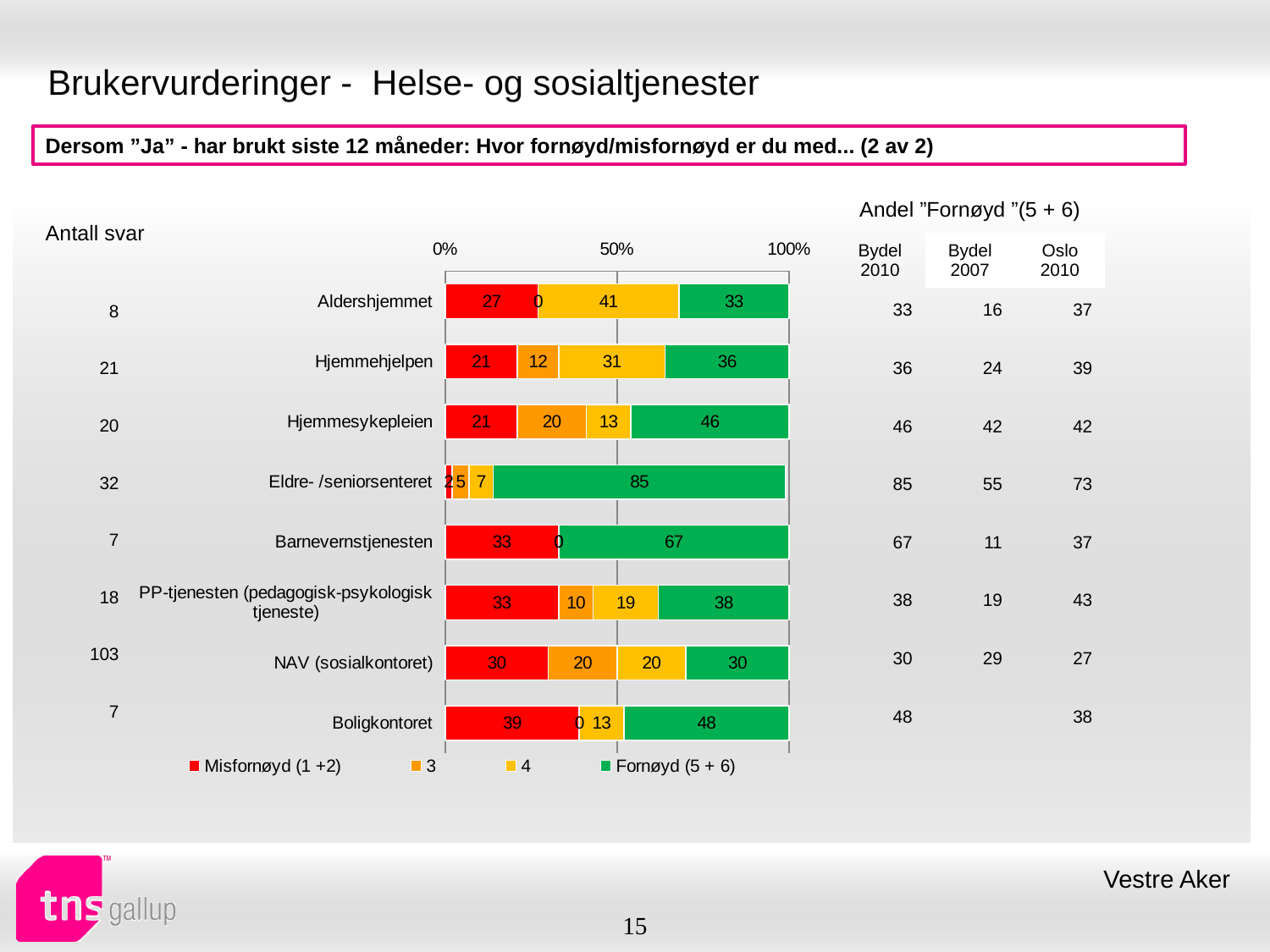
What kind of chart is shown on the slide? Stacked bar chart What is the Fornøyd (5 + 6) value for Eldre- /seniorsenteret? 85 Which has the larger Misfornøyd (1 +2) value, Boligkontoret or NAV (sosialkontoret)? Boligkontoret How many series does the chart legend list? 4 What is the value of the '4' segment for Aldershjemmet? 41 What is the value of the '3' segment for Hjemmesykepleien? 20 Which category has the highest Fornøyd (5 + 6) value? Eldre- /seniorsenteret How many service categories are plotted in the chart? 8 Which category has the lowest Fornøyd (5 + 6) value? NAV (sosialkontoret) What is the difference between the Fornøyd (5 + 6) values for Hjemmesykepleien and Hjemmehjelpen? 10 What colour represents the Fornøyd (5 + 6) series in the chart? Green What is the Misfornøyd (1 +2) value for Boligkontoret? 39